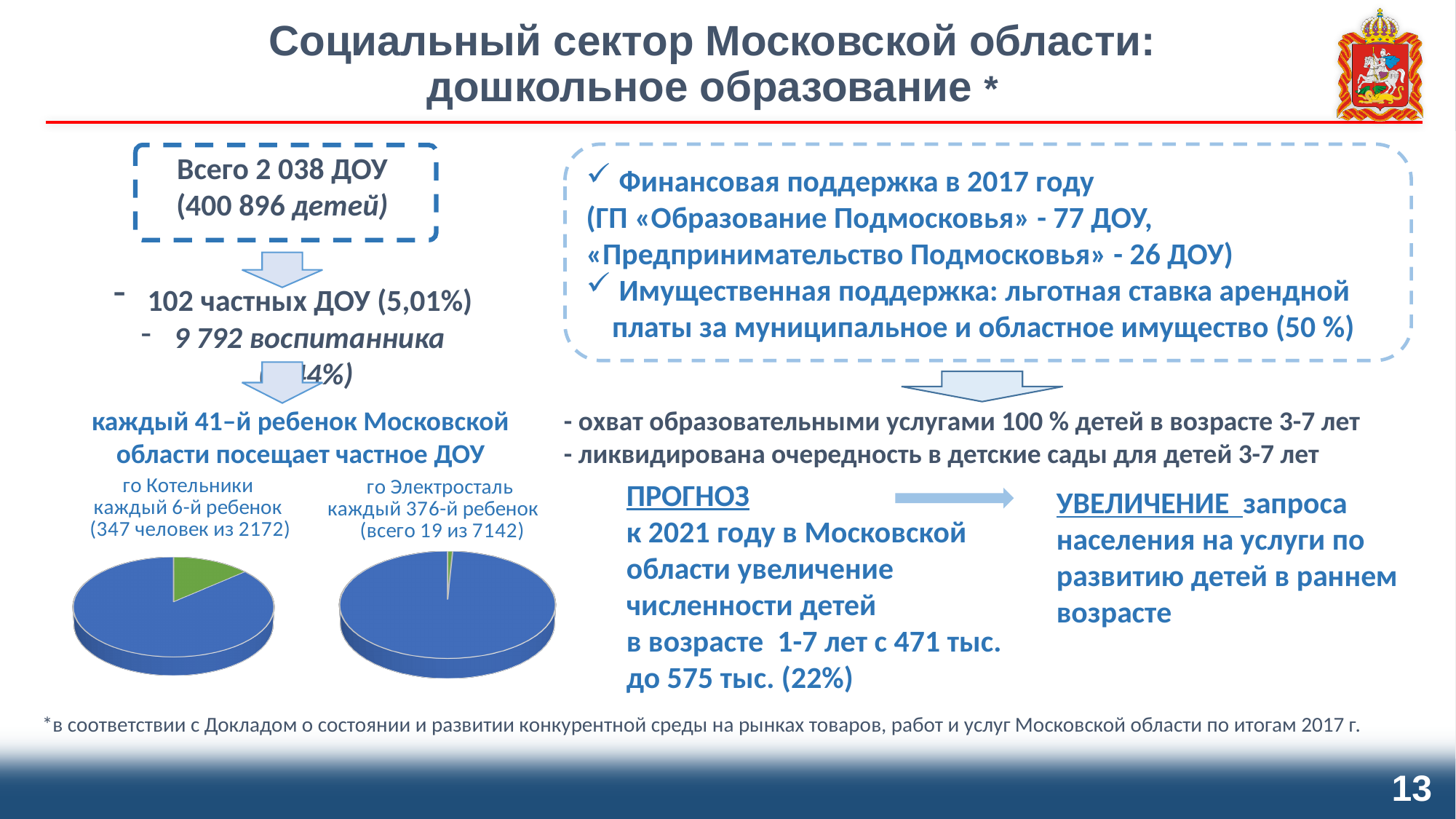
How many slices does the го Котельники pie chart have? 2 What kind of chart is used for го Котельники? pie chart In the го Электросталь chart, how many children do not attend a private ДОУ (total minus private)? 7123 How many pie charts are on the slide? 2 In the го Котельники chart, how many children do not attend a private ДОУ (total minus private)? 1825 In the го Электросталь chart, how many children attend a private ДОУ? 19 In the го Котельники chart, how many children out of the total attend a private ДОУ? 347 What colour is the larger slice in both pie charts? blue How many slices does the го Электросталь pie chart have? 2 Which pie chart has the larger green slice, го Котельники or го Электросталь? го Котельники In the го Котельники chart, what is the total number of children? 2172 In the го Электросталь chart, what is the total number of children? 7142